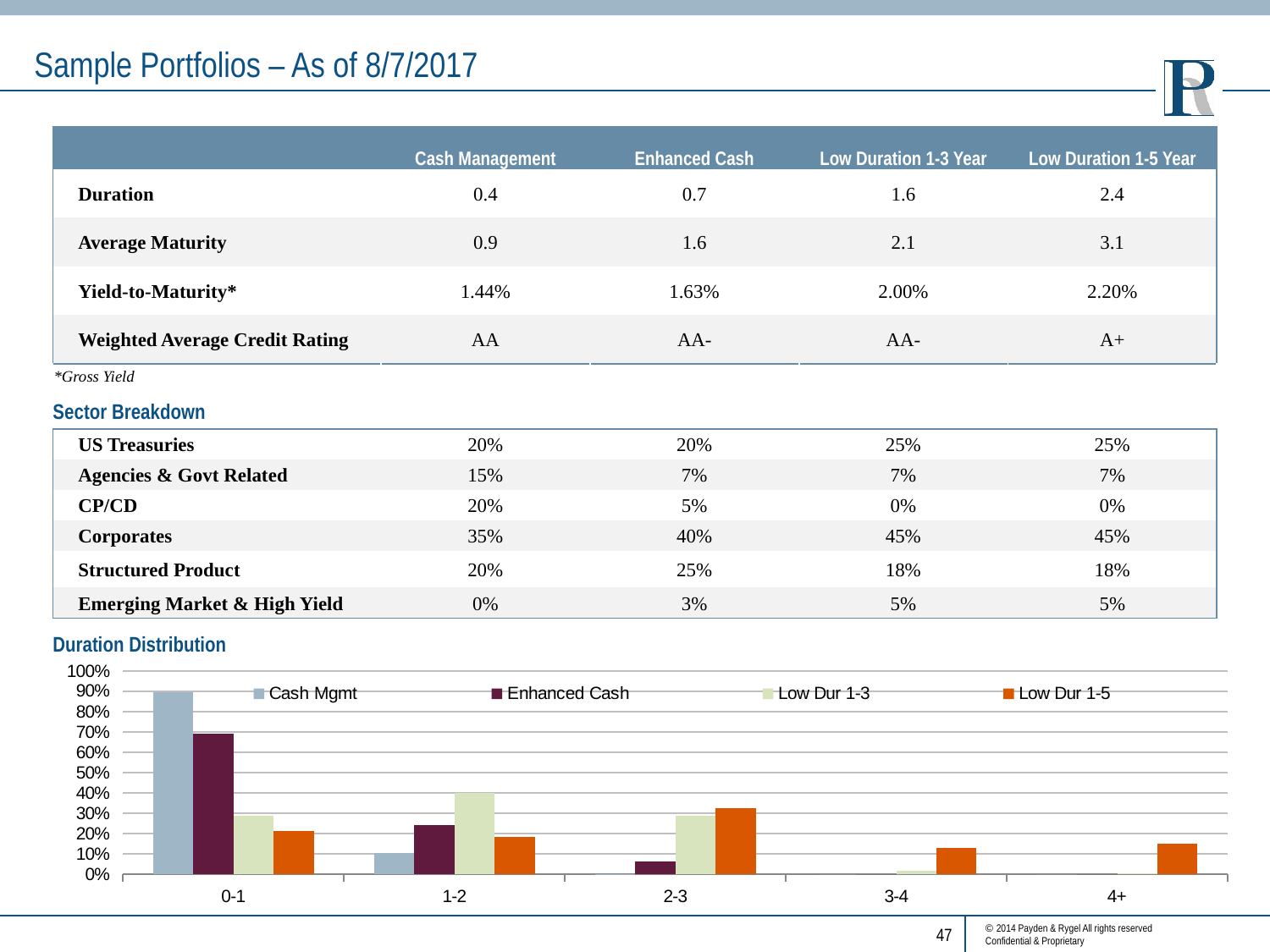
In the Duration Distribution chart, is the Low Dur 1-5 value for the 2-3 bucket greater or less than 40%? less In the Duration Distribution chart, is the Enhanced Cash value for the 0-1 bucket greater or less than 60%? greater How many duration buckets are shown on the x axis of the Duration Distribution chart? 5 In the Duration Distribution chart, do the Cash Mgmt values rise or fall from the 0-1 bucket to the 1-2 bucket? fall How many series does the legend of the Duration Distribution chart list? 4 In the Duration Distribution chart, which series has the highest value in the 1-2 bucket? Low Dur 1-3 In the Duration Distribution chart, is the Cash Mgmt value for the 0-1 bucket greater or less than 80%? greater What kind of chart is the Duration Distribution chart? bar chart In the Duration Distribution chart, which is larger in the 2-3 bucket: Enhanced Cash or Low Dur 1-5? Low Dur 1-5 In the Duration Distribution chart, which series has the highest value in the 0-1 bucket? Cash Mgmt What colour are the Low Dur 1-5 bars in the Duration Distribution chart? orange In the Duration Distribution chart, which series has the highest value in the 4+ bucket? Low Dur 1-5